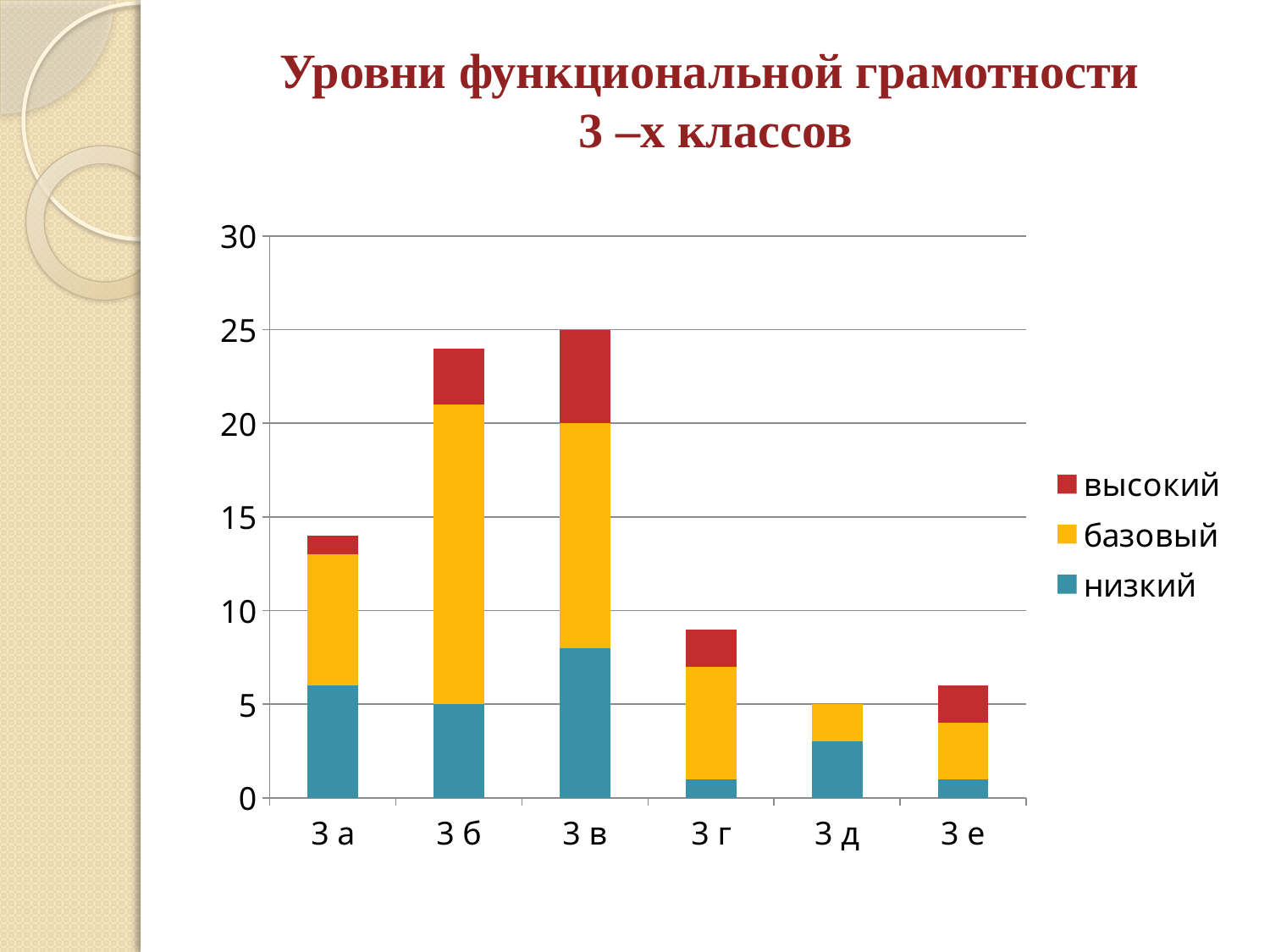
Which series is shown in red according to the legend? высокий How many classes (categories) are shown on the x axis? 6 What is the total height of the stacked bar for 3 д? 5 What is the value of the низкий segment for 3 б? 5 Is the total for 3 б greater or less than 20? greater What kind of chart is shown on the slide? Stacked bar chart Is the total for 3 г greater or less than 10? less How many series does the legend list? 3 Which class has the highest total bar? 3 в What is the title of the slide? Уровни функциональной грамотности 3 –х классов What is the total height of the stacked bar for 3 в? 25 Is the total for 3 а greater or less than 15? less